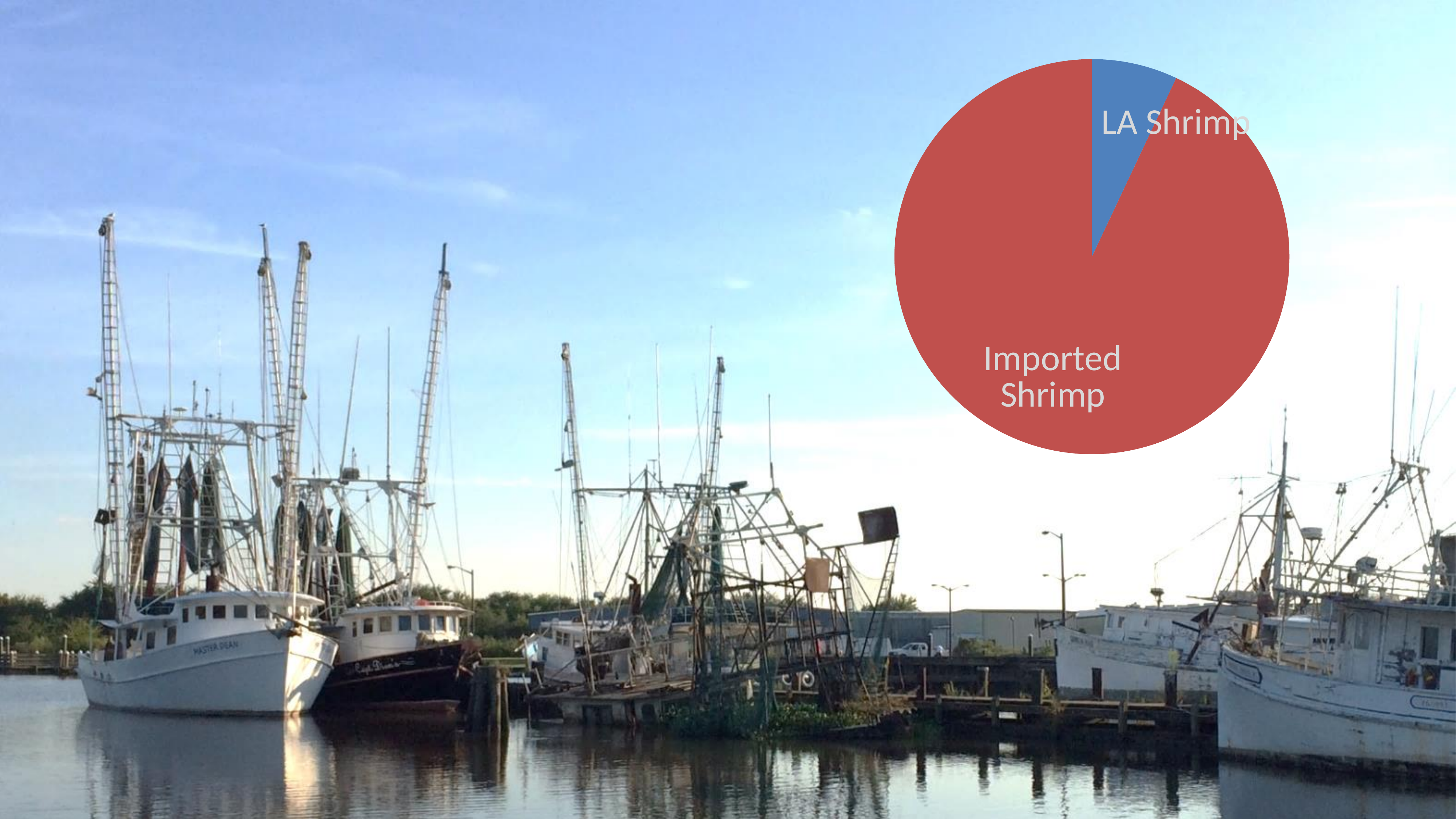
Which slice of the pie chart is the largest? Imported Shrimp What colour is the Imported Shrimp slice in the pie chart? red What colour is the LA Shrimp slice in the pie chart? blue How many slices does the pie chart have? 2 Which slice of the pie chart is the smallest? LA Shrimp Which is larger in the pie chart, LA Shrimp or Imported Shrimp? Imported Shrimp What kind of chart is shown on the slide? pie chart What are the two categories labelled in the pie chart? LA Shrimp and Imported Shrimp